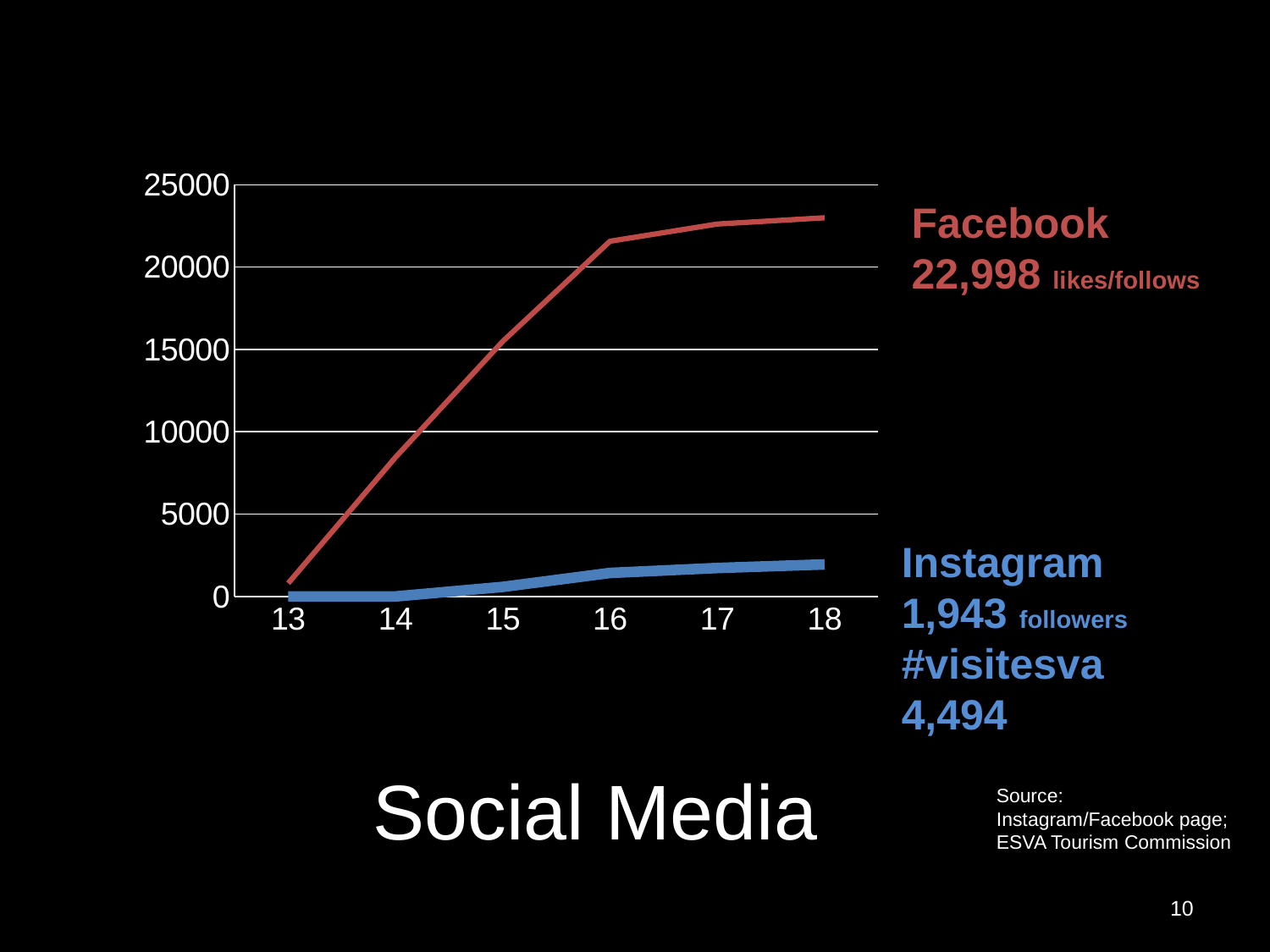
How many series are plotted on the chart? 2 Is the Facebook value at 13 greater or less than 5000? less What is the Facebook likes/follows figure printed on the slide? 22,998 What colour is the Facebook line on the chart? red Is the Instagram value at 18 greater or less than 5000? less What is the Instagram followers figure printed on the slide? 1,943 How many points are on the x axis of the chart? 6 Is the Facebook value at 16 greater or less than 20000? greater Does the Facebook line rise or fall from 13 to 18? rise At which x-axis point is the Facebook line at its lowest? 13 What kind of chart is shown on the slide? line chart At 18, which series has the larger value, Facebook or Instagram? Facebook